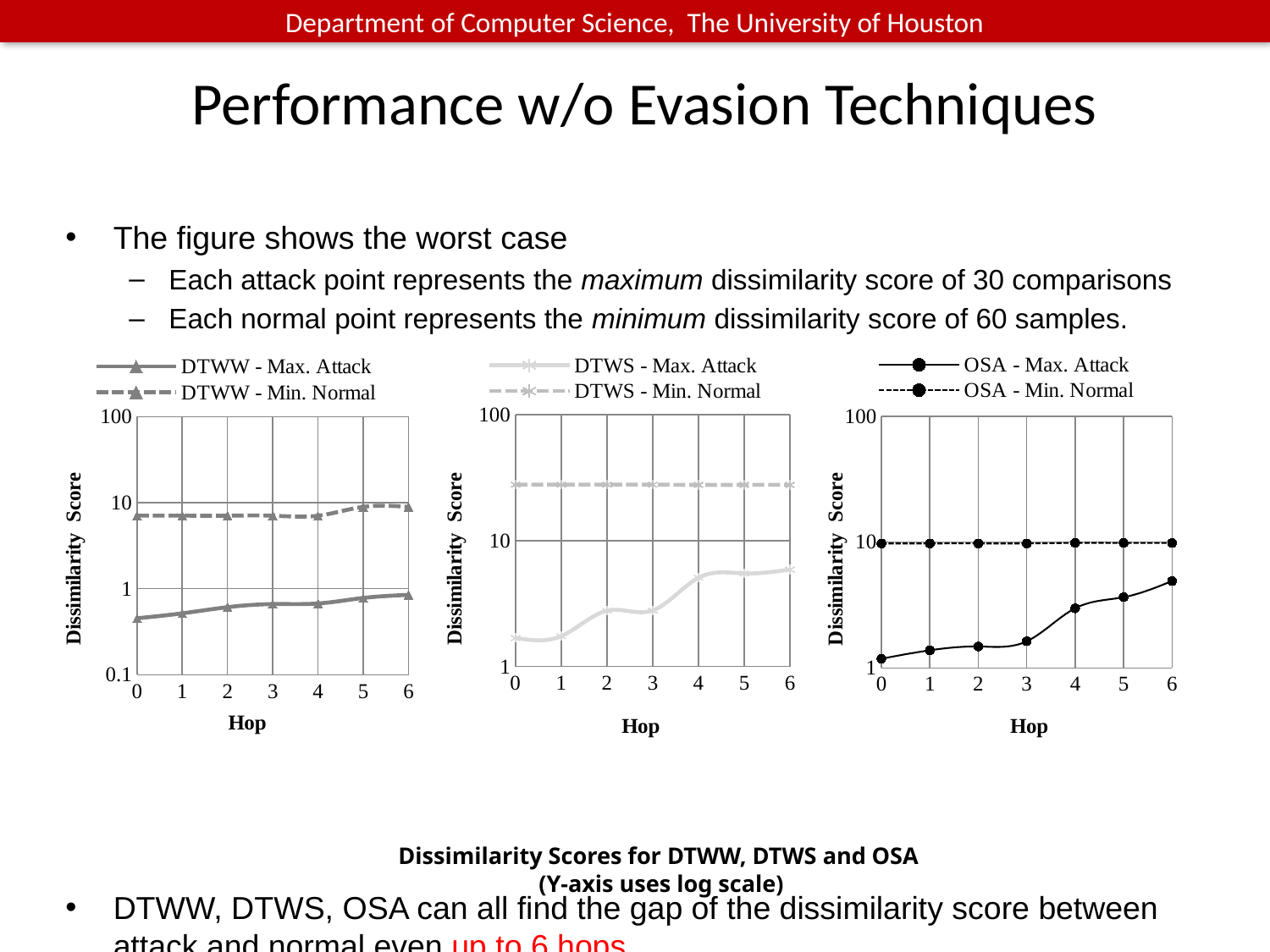
In the left chart (DTWW), is the value of DTWW - Min. Normal at hop 0 greater or less than 10? less In the middle chart (DTWS), is the value of DTWS - Max. Attack at hop 6 greater or less than 10? less What kind of chart is the left chart (DTWW)? line chart In the right chart (OSA), is the value of OSA - Max. Attack at hop 6 greater or less than 10? less In the left chart (DTWW), which series has the larger value at hop 3, DTWW - Max. Attack or DTWW - Min. Normal? DTWW - Min. Normal What is the x-axis label of the three charts? Hop In the right chart (OSA), does the OSA - Max. Attack series rise or fall from hop 0 to hop 6? rise In the middle chart (DTWS), does the DTWS - Max. Attack series rise or fall from hop 0 to hop 6? rise How many series does the legend of the right chart (OSA) list? 2 How many hop values are plotted along the x axis of the middle chart (DTWS)? 7